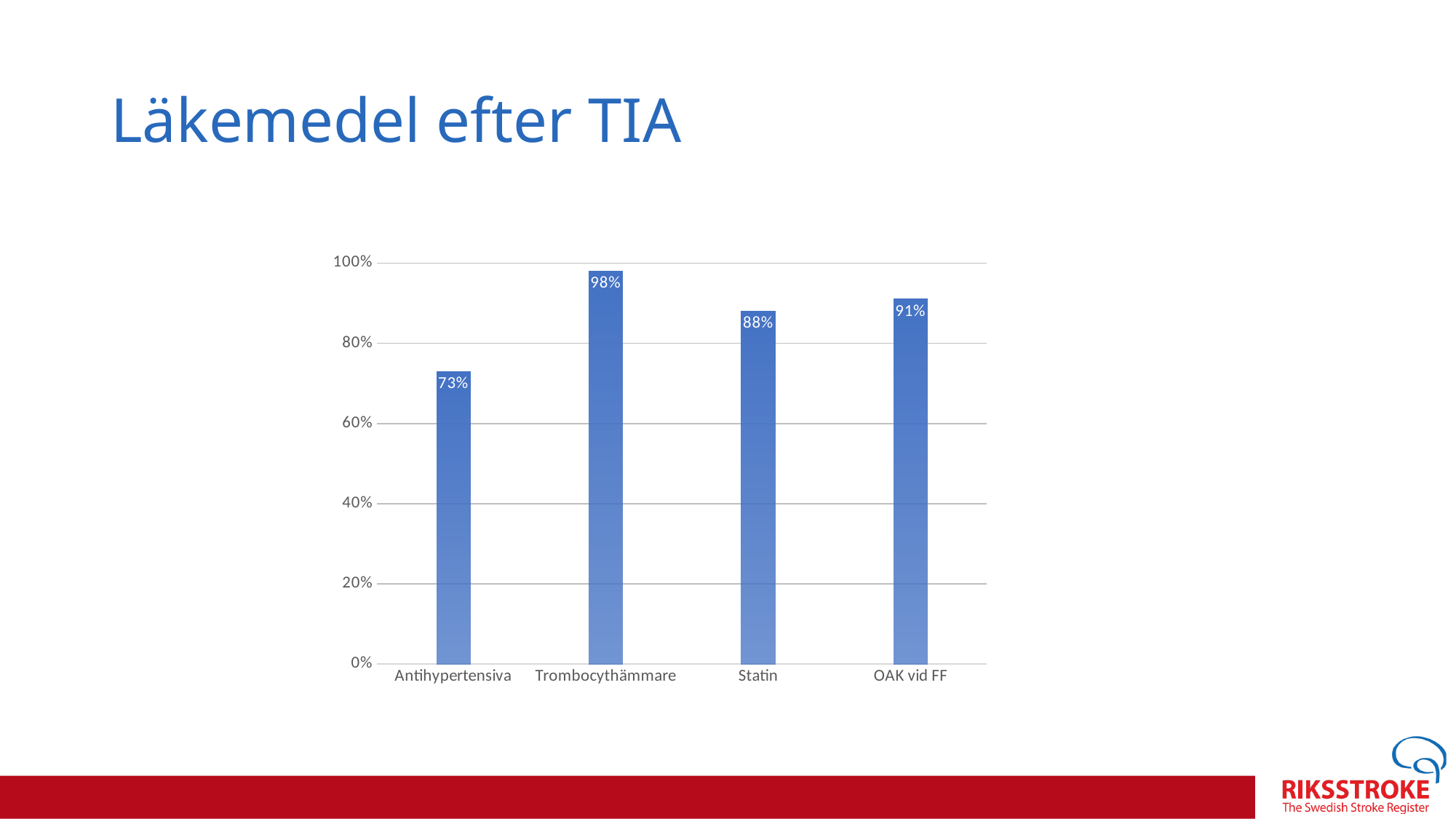
What kind of chart is shown on the slide? bar chart Which category has the lowest value? Antihypertensiva What is the difference between the values for Trombocythämmare and Antihypertensiva? 25% How many categories are shown in the chart? 4 Which is larger, the value for Statin or the value for OAK vid FF? OAK vid FF What is the value for Statin? 88% What is the difference between the values for OAK vid FF and Statin? 3% What is the value for Antihypertensiva? 73% Is the value for Antihypertensiva greater or less than 80%? less What is the value for OAK vid FF? 91% What is the value for Trombocythämmare? 98% Which category has the highest value? Trombocythämmare